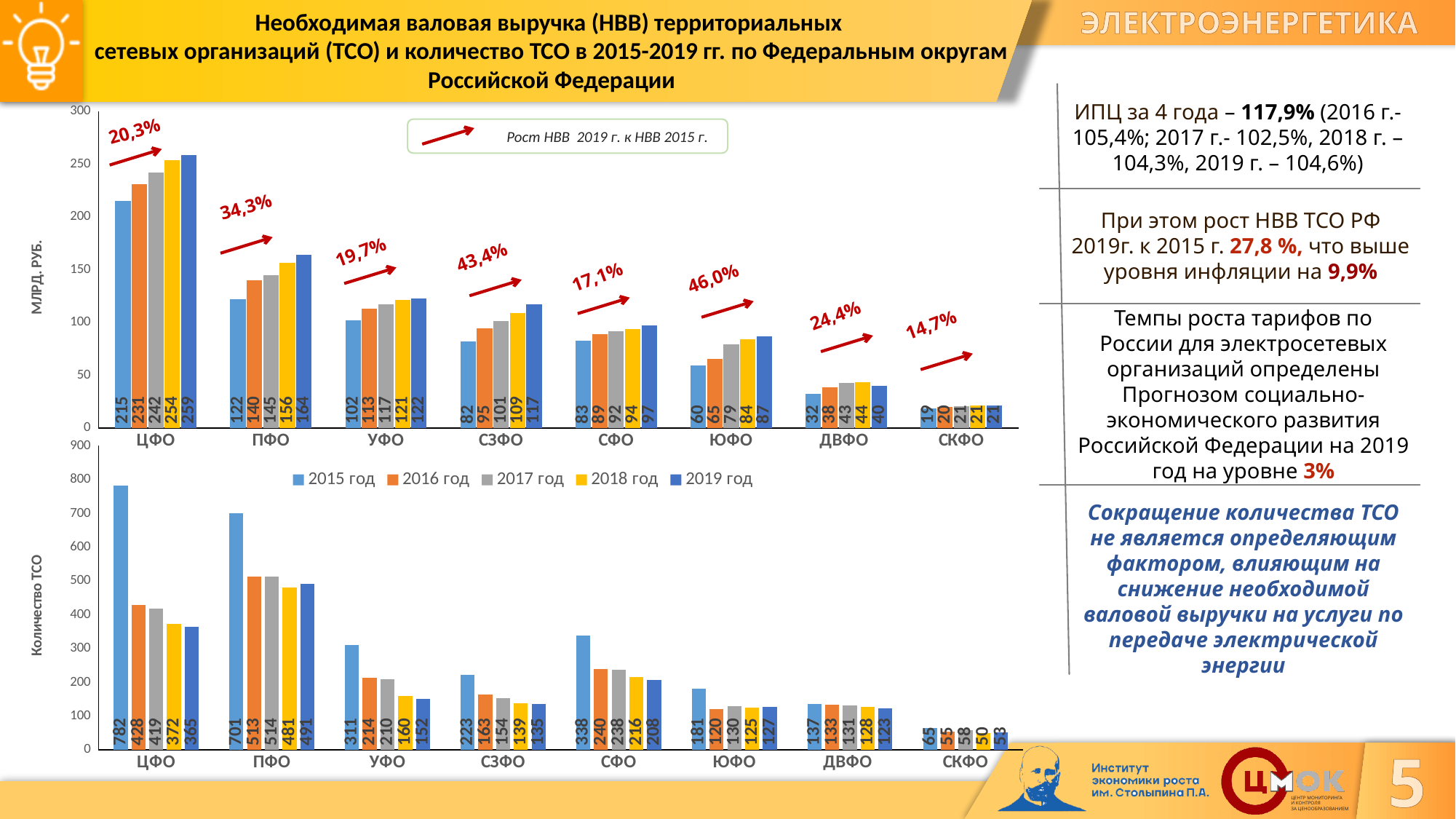
How many series does the legend list for the charts on this slide? 5 In the bottom chart (Количество ТСО), is the 2015 год value for ПФО greater or less than 600? greater In the top chart (НВВ, млрд. руб.), which federal district has the highest value in 2019 год? ЦФО How many federal districts are shown on the x axis of the top chart (НВВ, млрд. руб.)? 8 In the bottom chart (Количество ТСО), which federal district has the lowest value in 2015 год? СКФО What type of chart is the bottom chart (Количество ТСО)? bar chart In the bottom chart (Количество ТСО), which is larger for СФО: the 2015 год value or the 2019 год value? 2015 год In the bottom chart (Количество ТСО), what is the value for ЦФО in 2015 год? 782 In the top chart (НВВ, млрд. руб.), what is the value for ЦФО in 2019 год? 259 In the bottom chart (Количество ТСО), do the values for УФО rise or fall from 2015 год to 2019 год? fall In the top chart (НВВ, млрд. руб.), what growth percentage of НВВ 2019 to НВВ 2015 is shown above ЮФО? 46,0% In the top chart (НВВ, млрд. руб.), what is the difference between the 2019 год and 2015 год values for ПФО? 42